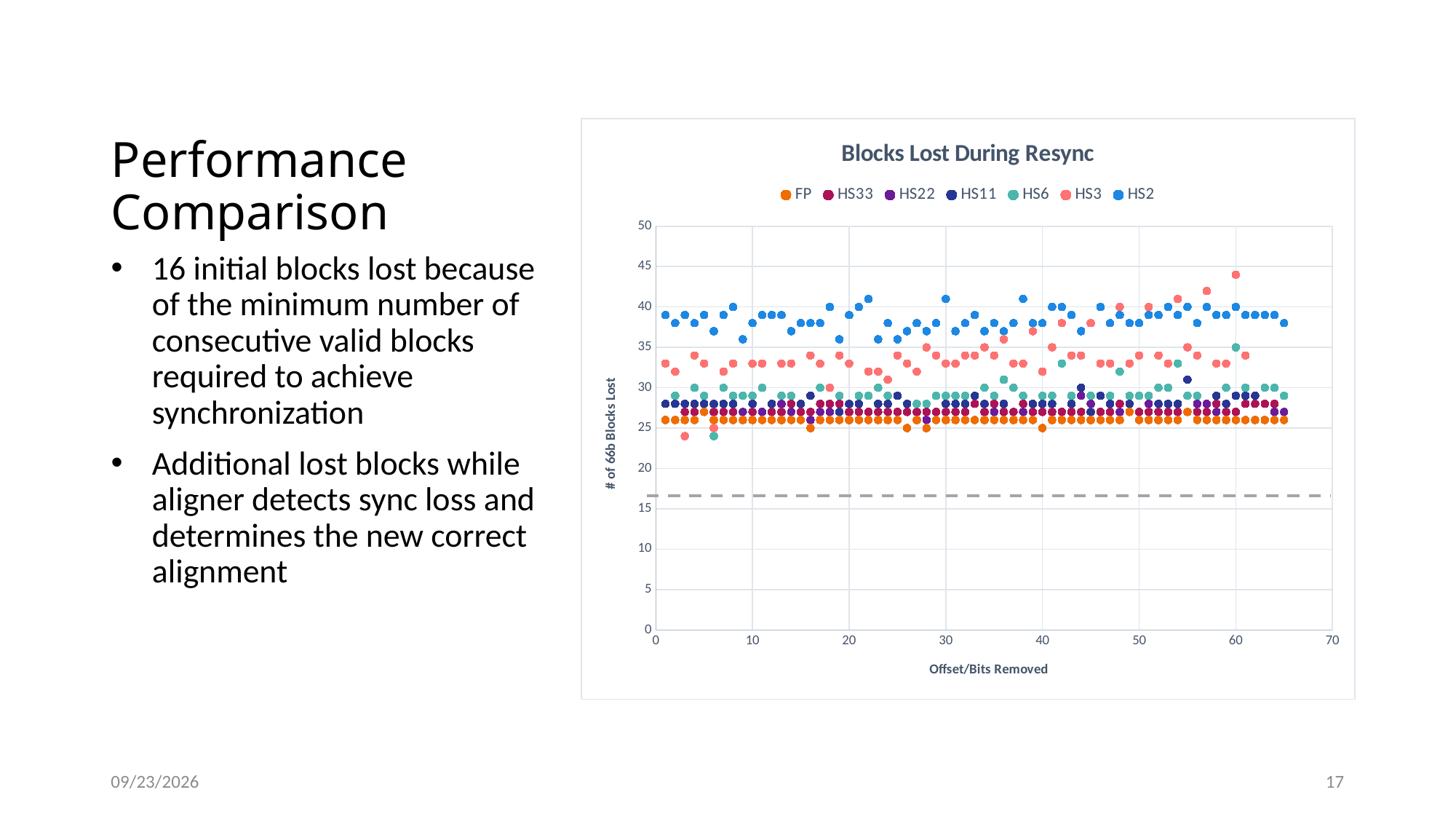
How many series does the chart's legend list? 7 Which series has larger values, HS2 or FP? HS2 What is the label of the vertical axis? # of 66b Blocks Lost Which series has the lowest values overall on the chart? FP Which series has larger values, HS3 or HS33? HS3 Is the dashed horizontal reference line on the chart greater or less than 20? less Which series has the highest values overall on the chart? HS2 What is the title of the chart? Blocks Lost During Resync Are the values for the HS3 series generally greater or less than 30? greater What kind of chart is shown on the slide? scatter chart Are the values for the FP series greater or less than 30? less